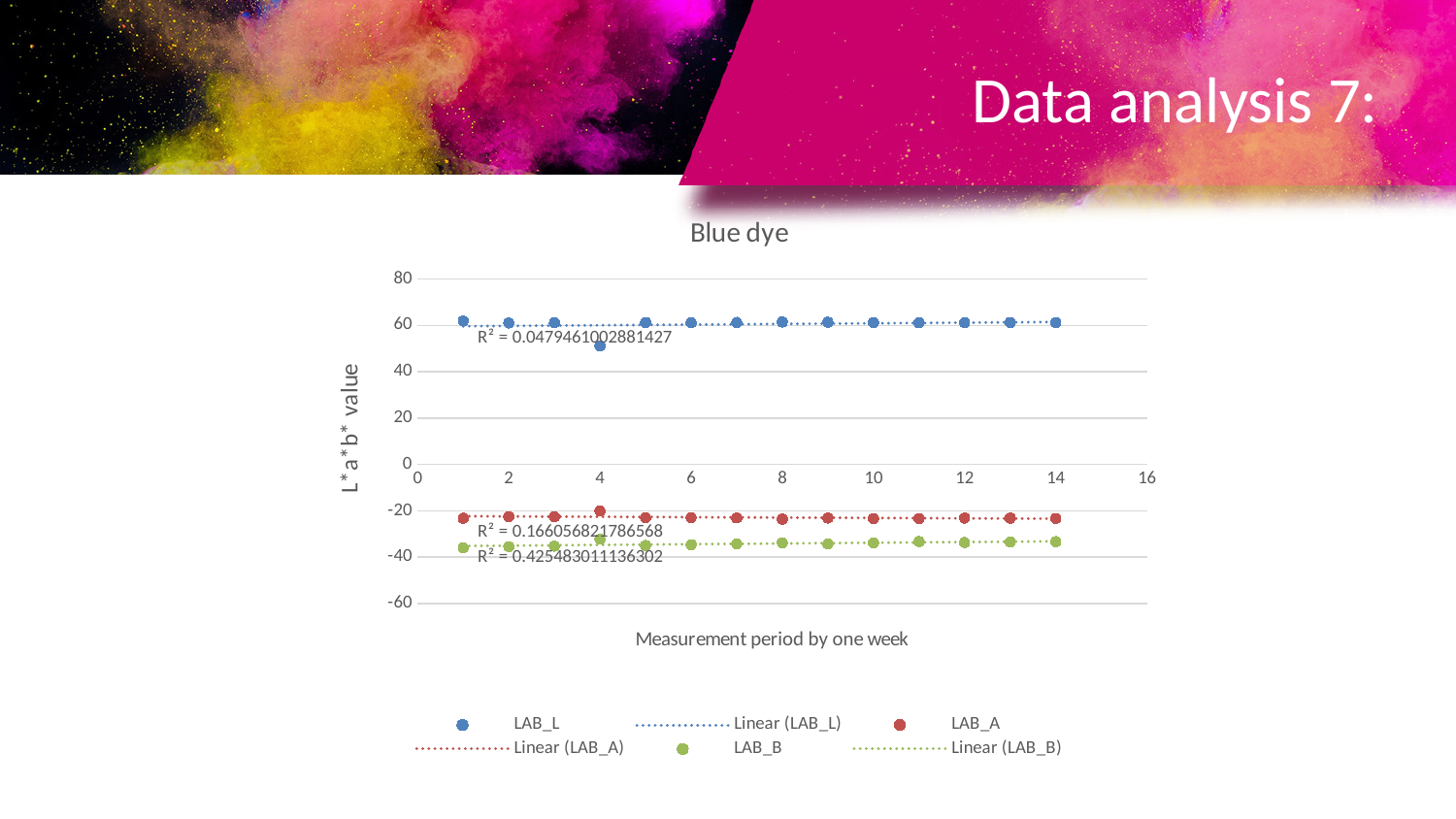
Which series has the lowest plotted values? LAB_B What is the R² value shown for the Linear (LAB_L) trendline? 0.0479461002881427 What is the label of the vertical axis? L*a*b* value Is the LAB_B value at week 10 greater or less than -20? less What type of chart is shown on the slide? scatter chart What is the R² value shown for the Linear (LAB_A) trendline? 0.166056821786568 How many entries does the legend list? 6 Which series has the highest plotted values? LAB_L What is the title of the chart? Blue dye How many data points are plotted for the LAB_L series? 14 What is the R² value shown for the Linear (LAB_B) trendline? 0.425483011136302 Is the LAB_L value at week 8 greater or less than 40? greater